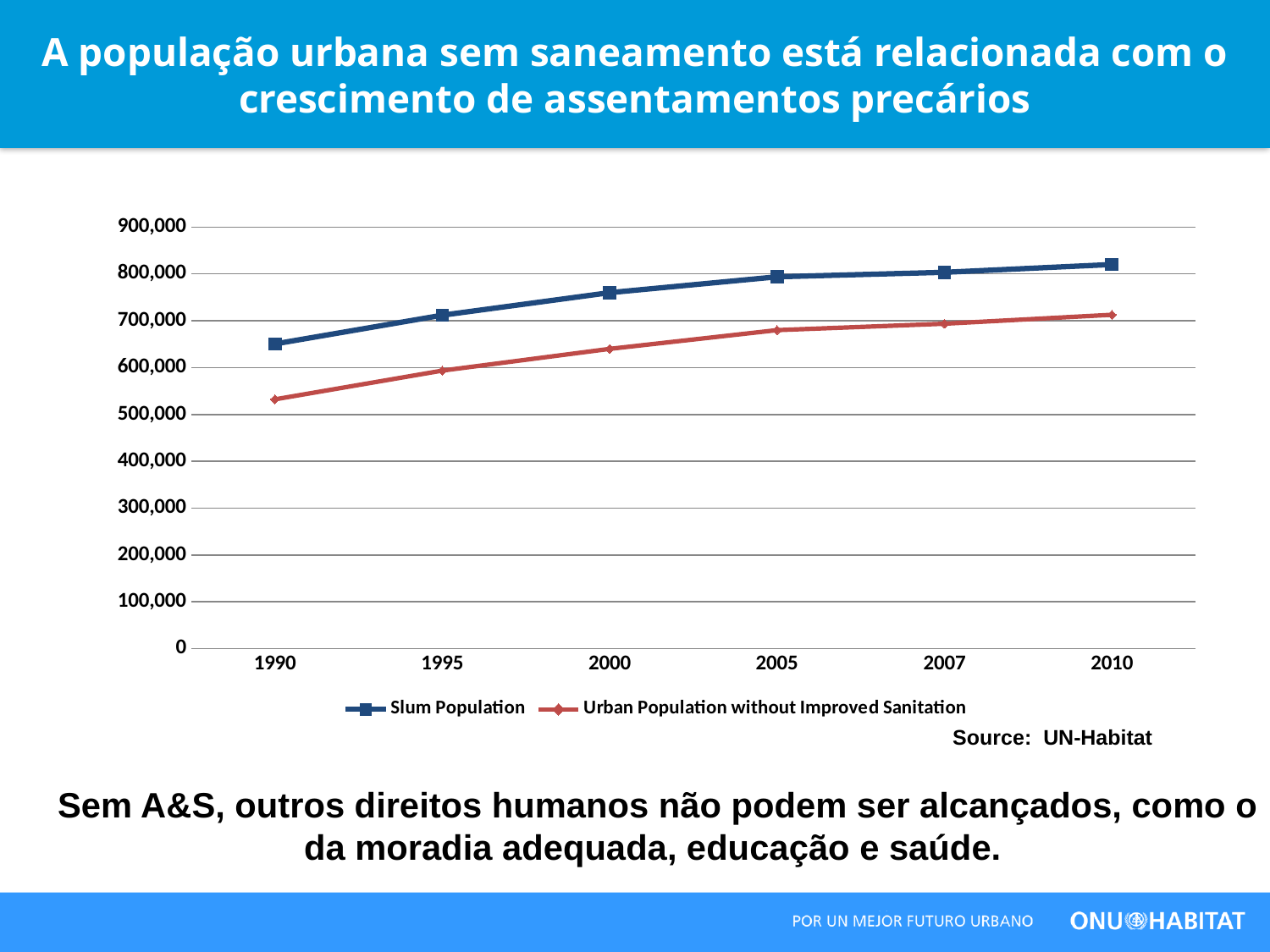
Which series is larger in 2010, Slum Population or Urban Population without Improved Sanitation? Slum Population Is the Urban Population without Improved Sanitation value for 1990 greater or less than 600,000? less Is the Slum Population value for 1990 greater or less than 600,000? greater Does the Slum Population series rise or fall from 1990 to 2010? rise Is the Urban Population without Improved Sanitation value for 2000 greater or less than 700,000? less In which year is the Urban Population without Improved Sanitation highest? 2010 How many years are plotted along the x axis of the chart? 6 In which year is the Slum Population lowest? 1990 How many series does the chart legend list? 2 What kind of chart is shown on the slide? line chart What source is cited below the chart? UN-Habitat